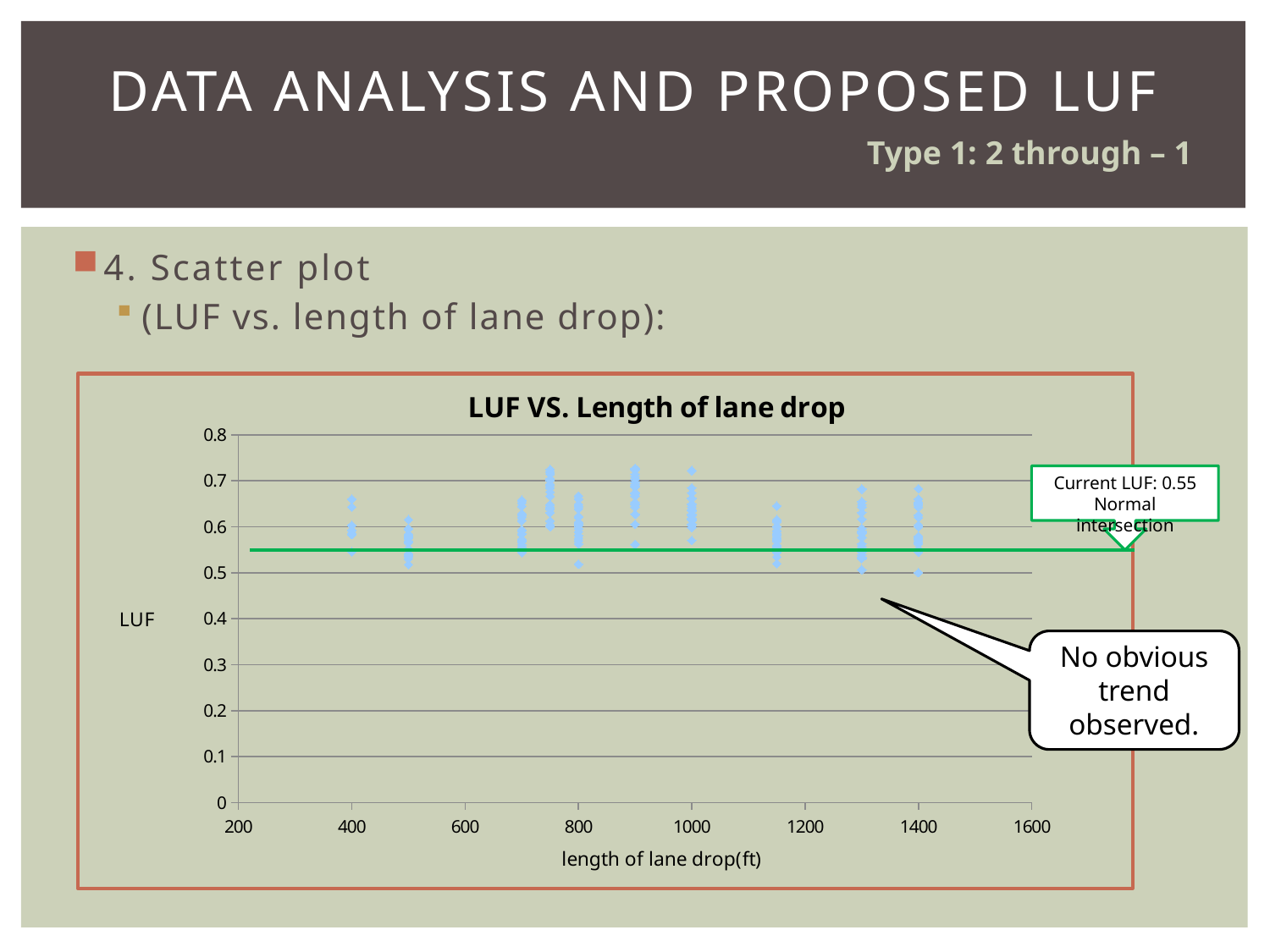
What is the largest value shown on the x axis of the chart? 1600 Are the LUF values plotted at a lane drop length of 1000 ft greater or less than 0.5? greater Are the LUF values plotted at a lane drop length of 400 ft greater or less than 0.5? greater What value does the green horizontal line labelled 'Current LUF' mark on the chart? 0.55 What is the label of the x axis of the chart? length of lane drop(ft) What kind of chart is shown on the slide? scatter plot Are the LUF values plotted at a lane drop length of 500 ft greater or less than 0.7? less According to the callout on the chart, is there a clear trend in LUF as the length of lane drop increases? No obvious trend observed How many distinct lane drop lengths have points plotted on the chart? 10 What is the title of the chart? LUF VS. Length of lane drop